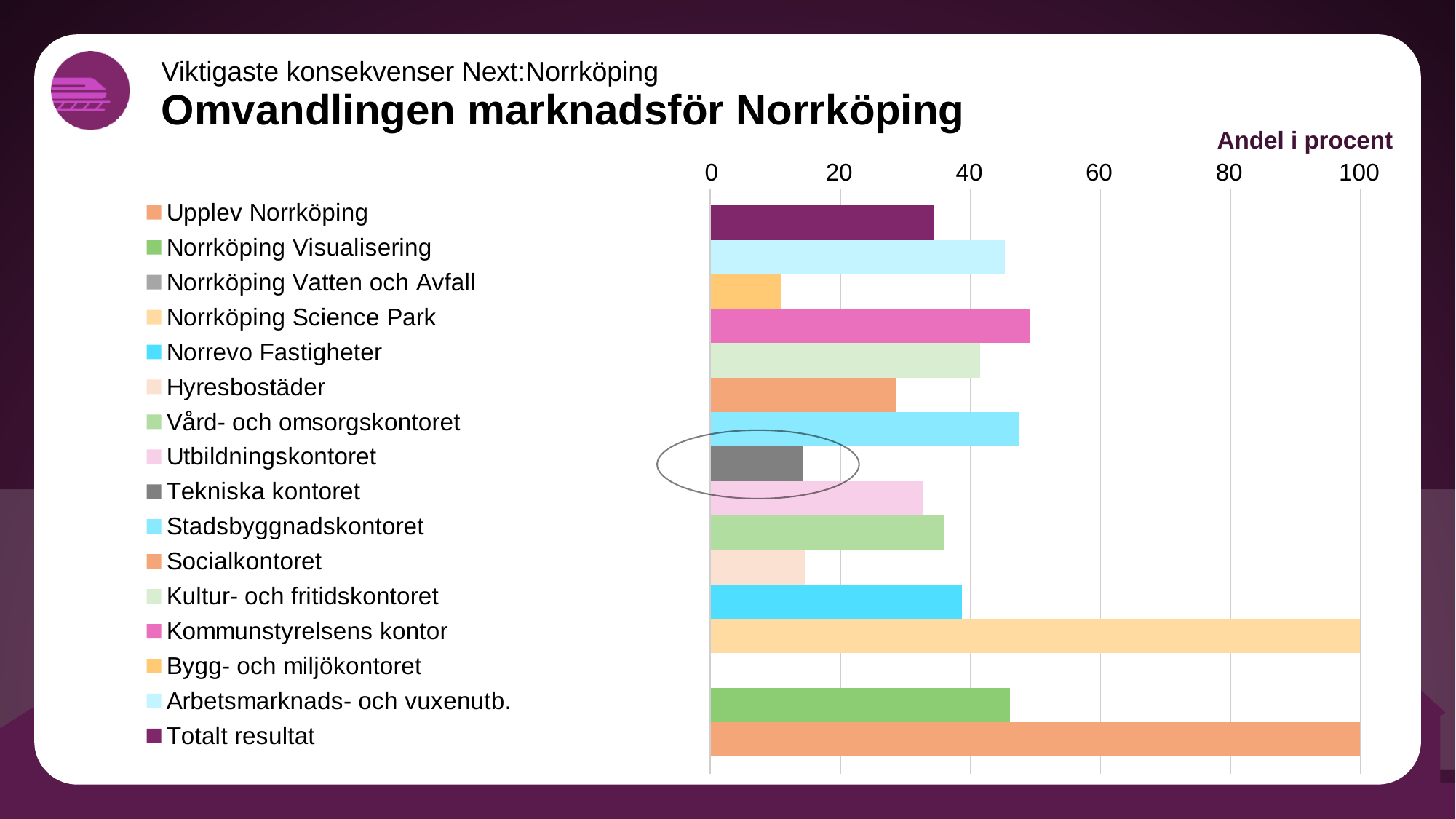
Is the value for Kommunstyrelsens kontor greater or less than 40? greater Which has the larger value, Tekniska kontoret or Utbildningskontoret? Utbildningskontoret What is the highest value shown on the horizontal axis of the chart? 100 Is the value for Tekniska kontoret greater or less than 20? less What kind of chart is shown on the slide? bar chart Is the value for Upplev Norrköping greater or less than 80? greater What label is shown above the horizontal axis of the chart? Andel i procent Which has the larger value, Kommunstyrelsens kontor or Socialkontoret? Kommunstyrelsens kontor How many entries does the chart legend list? 16